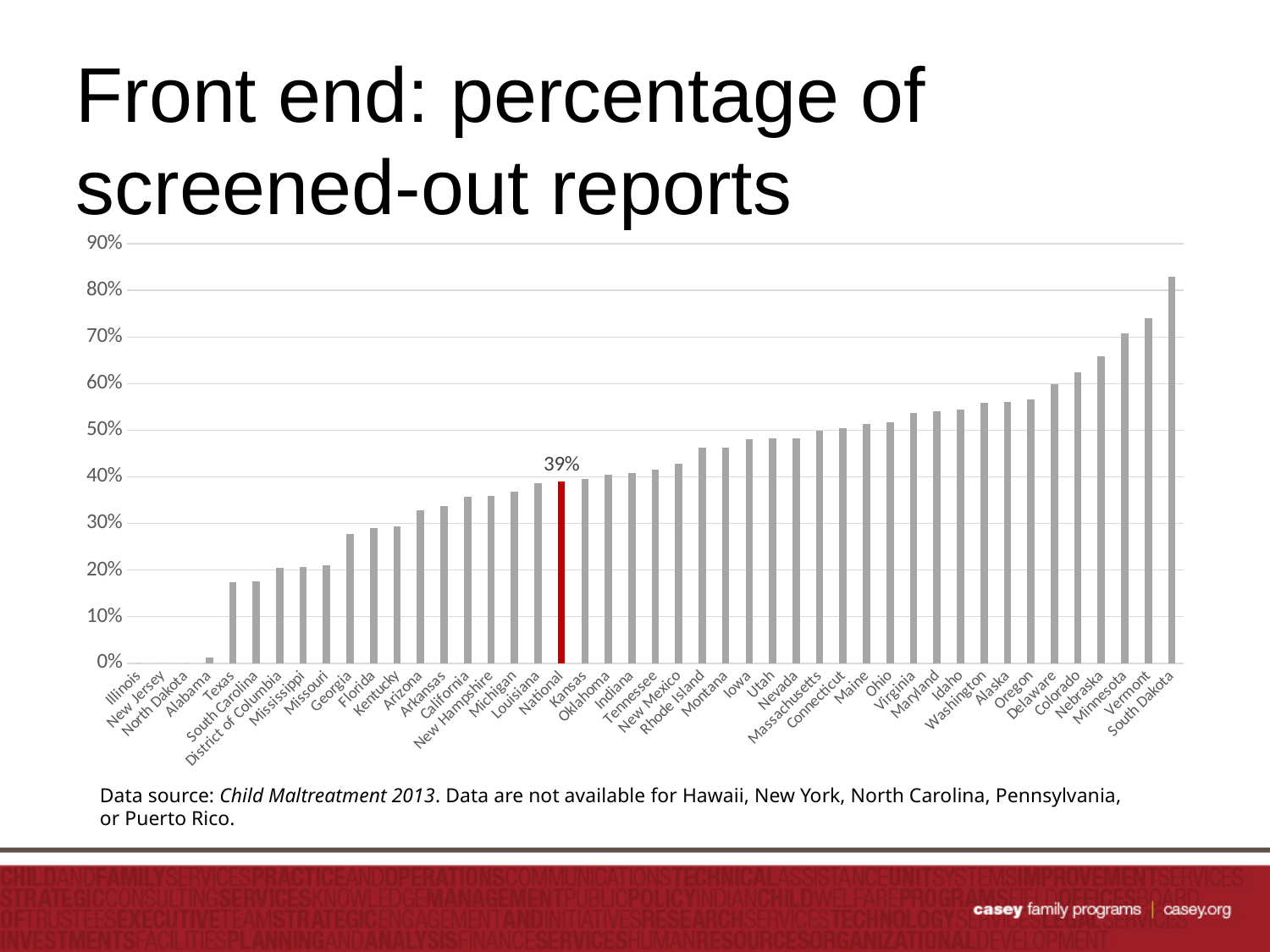
How many bars (categories) are shown on the x axis? 45 Which has a higher percentage of screened-out reports, Vermont or Texas? Vermont Is the value for Texas greater or less than 20%? less Is the value for Georgia greater or less than 30%? less Is the value for Iowa greater or less than 50%? less Which category has the highest percentage of screened-out reports? South Dakota What kind of chart is shown on the slide? bar chart What value is labeled on the National bar? 39% What colour is the National bar? red Do the bar values rise or fall from left to right along the x axis? rise